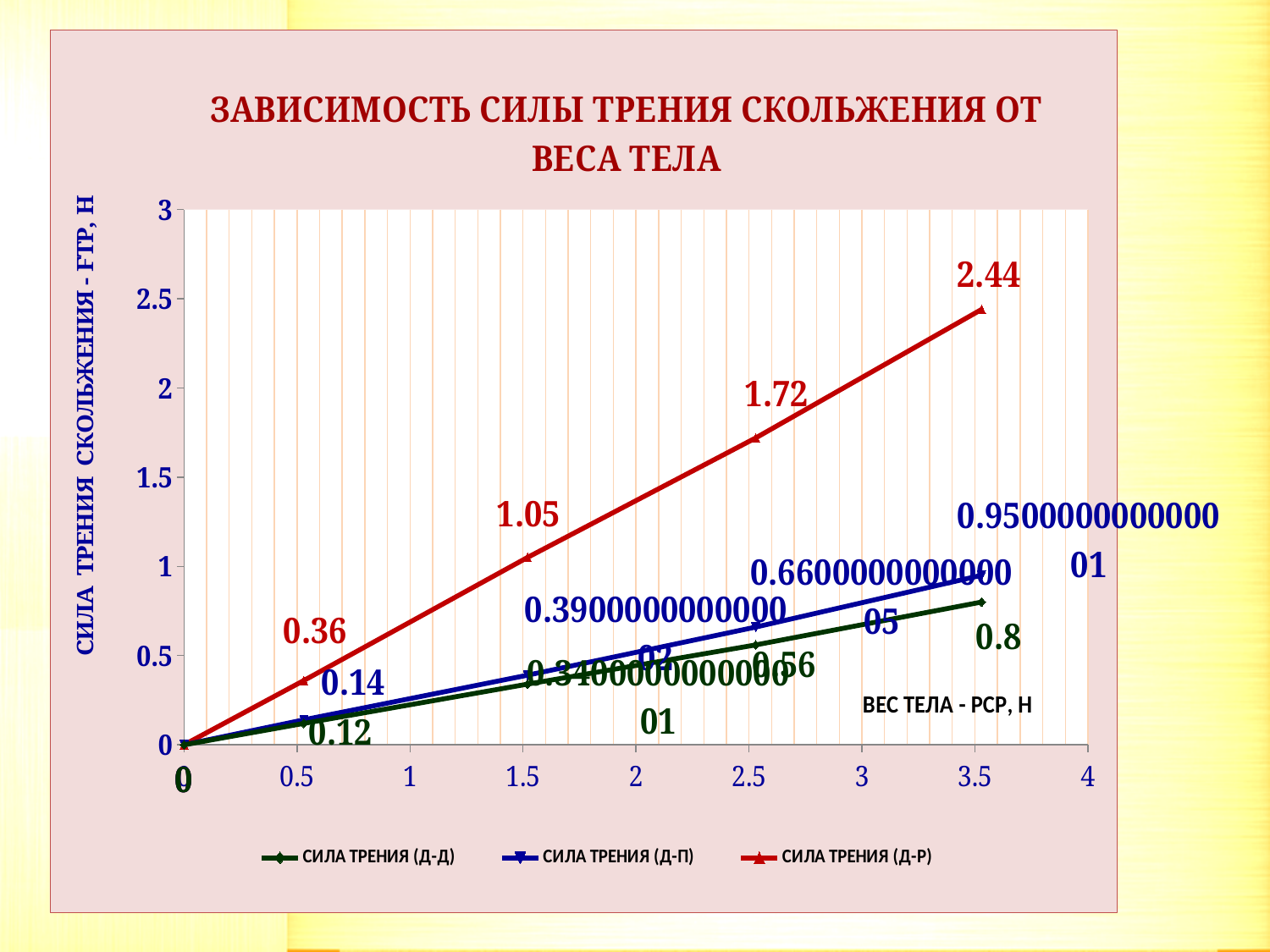
What is the highest labelled value of the series СИЛА ТРЕНИЯ (Д-Р)? 2.44 How many series does the legend list? 3 Do the values of the series СИЛА ТРЕНИЯ (Д-Р) rise or fall as body weight increases along the x axis? rise What is the difference between the highest value of СИЛА ТРЕНИЯ (Д-Р) (2.44) and the highest value of СИЛА ТРЕНИЯ (Д-Д) (0.8)? 1.64 What is the highest labelled value of the series СИЛА ТРЕНИЯ (Д-Д)? 0.8 What is the difference between the last two labelled values of СИЛА ТРЕНИЯ (Д-Р), 2.44 and 1.72? 0.72 What is the value of the fourth labelled point of the series СИЛА ТРЕНИЯ (Д-Д)? 0.56 Which series reaches the highest value at the right end of the chart: СИЛА ТРЕНИЯ (Д-Р) or СИЛА ТРЕНИЯ (Д-Д)? СИЛА ТРЕНИЯ (Д-Р) What kind of chart is shown on the slide? line chart Is the last point of the series СИЛА ТРЕНИЯ (Д-П) greater or less than 1.5? less What is the value of the second labelled point (after 0) of the series СИЛА ТРЕНИЯ (Д-Р)? 0.36 What is the value of the fourth labelled point of the series СИЛА ТРЕНИЯ (Д-Р)? 1.72